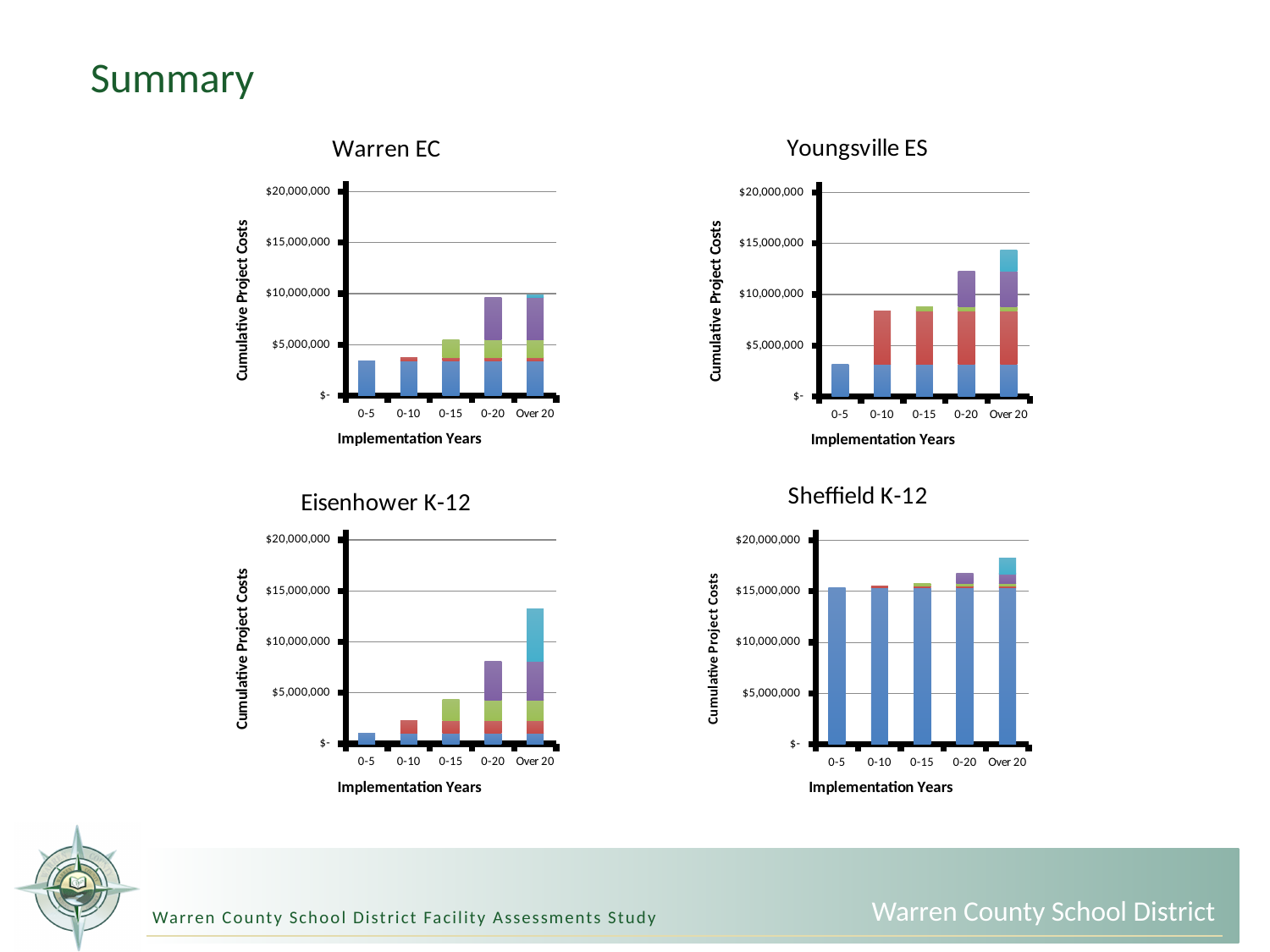
What kind of chart is the Warren EC chart? Stacked bar chart In the Youngsville ES chart, is the cumulative project cost for Over 20 greater or less than $15,000,000? less In the Eisenhower K-12 chart, do the cumulative project costs rise or fall from 0-5 to Over 20? rise In the Eisenhower K-12 chart, which implementation-year category has the highest cumulative project cost? Over 20 What is the label on the y axis of the Sheffield K-12 chart? Cumulative Project Costs In the Sheffield K-12 chart, is the cumulative project cost for Over 20 greater or less than $20,000,000? less In the Youngsville ES chart, which implementation-year category has the lowest cumulative project cost? 0-5 In the Youngsville ES chart, which has the larger cumulative project cost, 0-5 or 0-10? 0-10 In the Warren EC chart, is the cumulative project cost for 0-5 greater or less than $5,000,000? less How many implementation-year categories are shown on the x axis of the Youngsville ES chart? 5